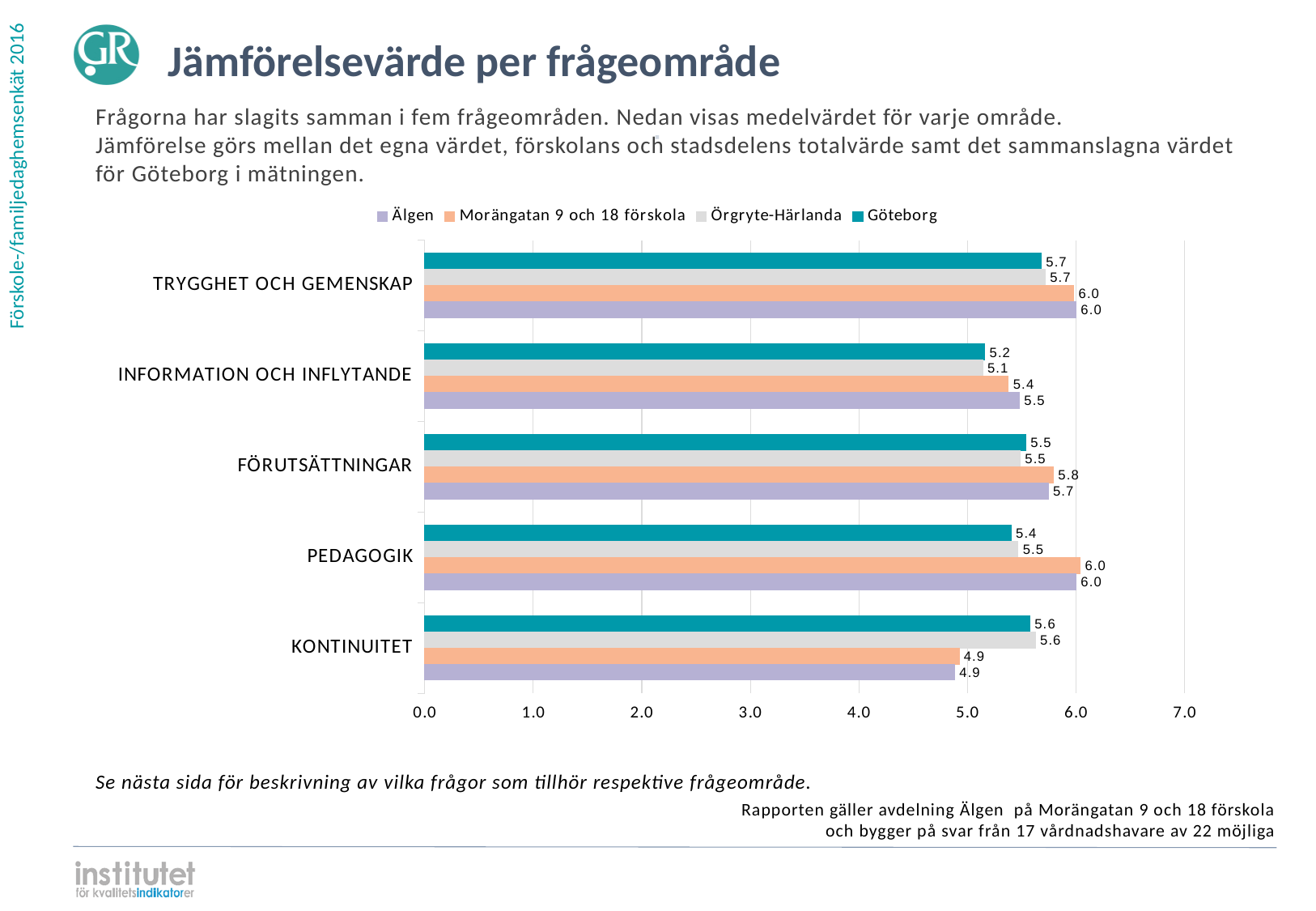
What is the value for Morängatan 9 och 18 förskola in the FÖRUTSÄTTNINGAR category? 5.8 What kind of chart is shown on the slide? bar chart What is the value for Göteborg in the INFORMATION OCH INFLYTANDE category? 5.2 In which category does Älgen have its lowest value? KONTINUITET How many categories are shown on the chart? 5 In which category does Göteborg have its highest value? TRYGGHET OCH GEMENSKAP What is the value for Örgryte-Härlanda in the PEDAGOGIK category? 5.5 In the PEDAGOGIK category, which is larger: the value for Älgen or the value for Göteborg? Älgen What is the value for Älgen in the KONTINUITET category? 4.9 What is the difference between the Göteborg value and the Älgen value in the KONTINUITET category? 0.7 How many series does the legend list? 4 Is the value for Älgen in the KONTINUITET category greater or less than 5.0? less